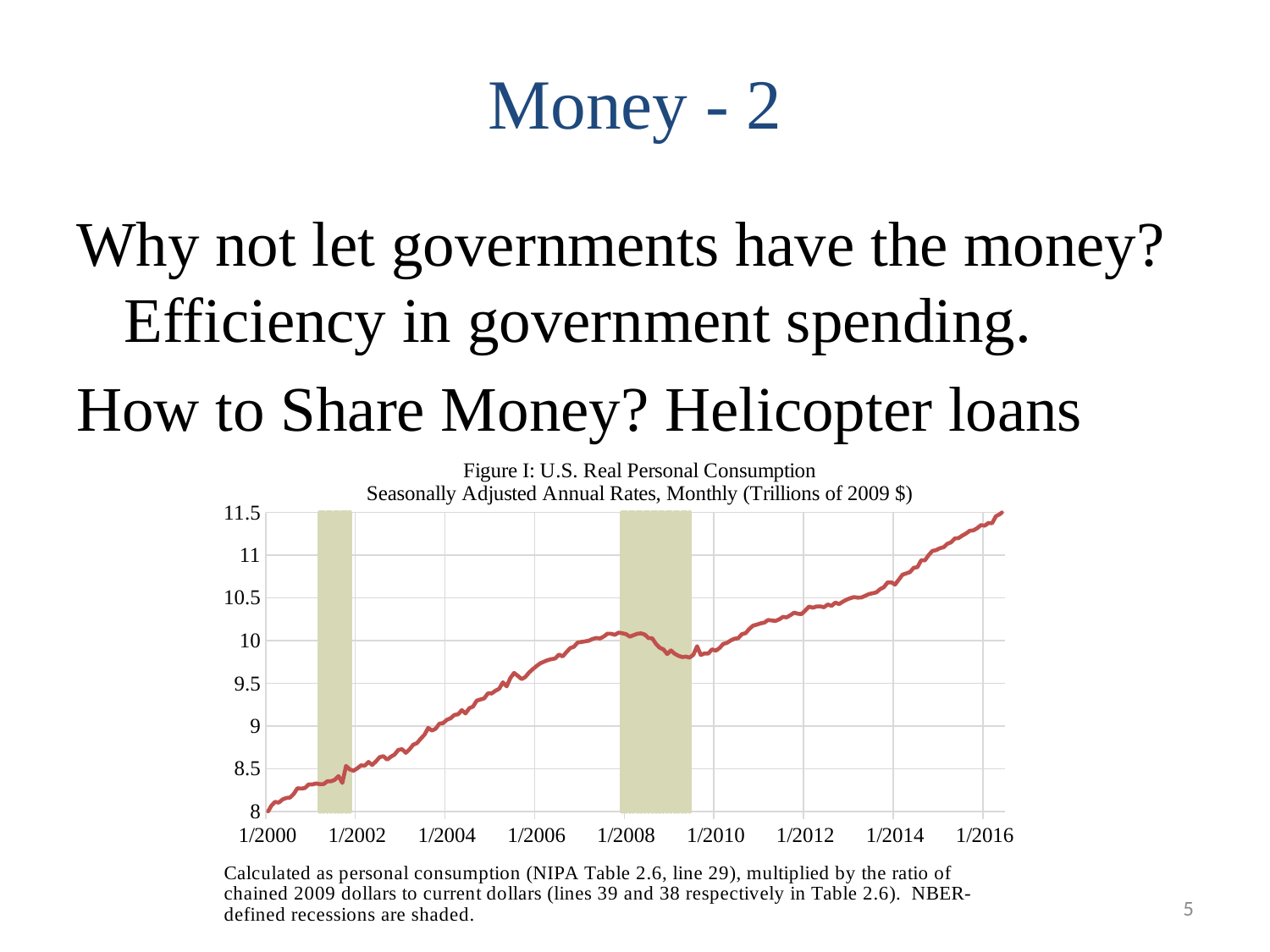
How many shaded recession periods are shown on the chart? 2 Is the value at 1/2012 greater or less than 10? greater Which is larger, the value at 1/2000 or the value at 1/2016? 1/2016 What kind of chart is shown on the slide? line chart Is the value at 1/2016 greater or less than 11? greater Overall, does U.S. real personal consumption rise or fall from 1/2000 to 1/2016? rise Is the value at 1/2014 greater or less than 10.5? greater What is the title of the chart? Figure I: U.S. Real Personal Consumption Seasonally Adjusted Annual Rates, Monthly (Trillions of 2009 $) At which x-axis date shown is real personal consumption at its lowest? 1/2000 At which x-axis date shown is real personal consumption at its highest? 1/2016